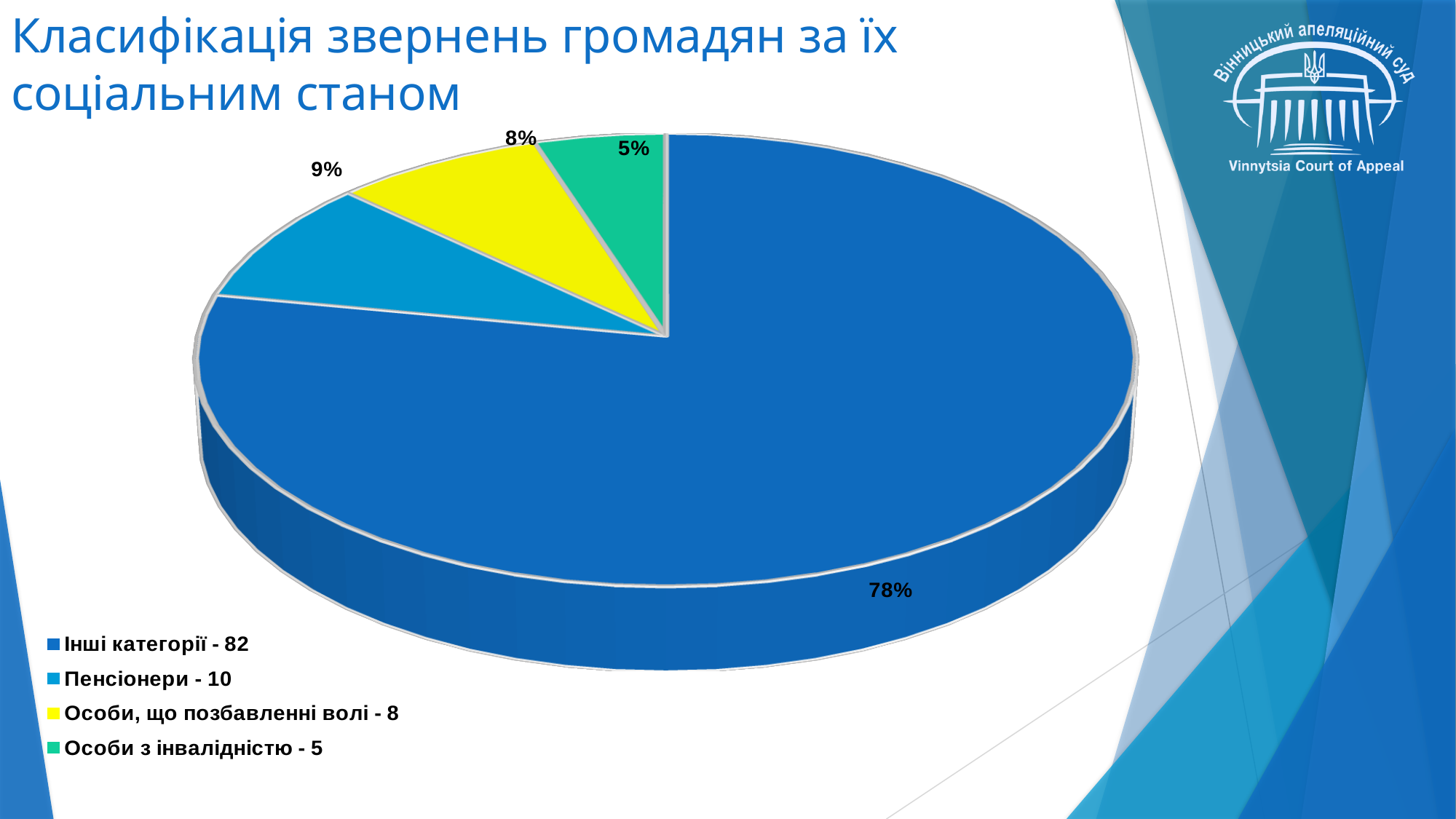
Which slice is larger: "Пенсіонери" or "Особи з інвалідністю"? Пенсіонери What percentage share does the slice for "Особи з інвалідністю" have? 5% What is the difference in percentage points between the "Інші категорії" slice and the "Пенсіонери" slice? 69 What percentage share does the slice for "Особи, що позбавленні волі" have? 8% What percentage share does the slice for "Пенсіонери" have? 9% Which category has the largest slice of the pie? Інші категорії How many slices does the pie chart have? 4 What colour is the slice for "Особи, що позбавленні волі"? yellow What kind of chart is shown on the slide? pie chart Which category has the smallest slice of the pie? Особи з інвалідністю According to the legend, how many appeals are in the "Пенсіонери" category? 10